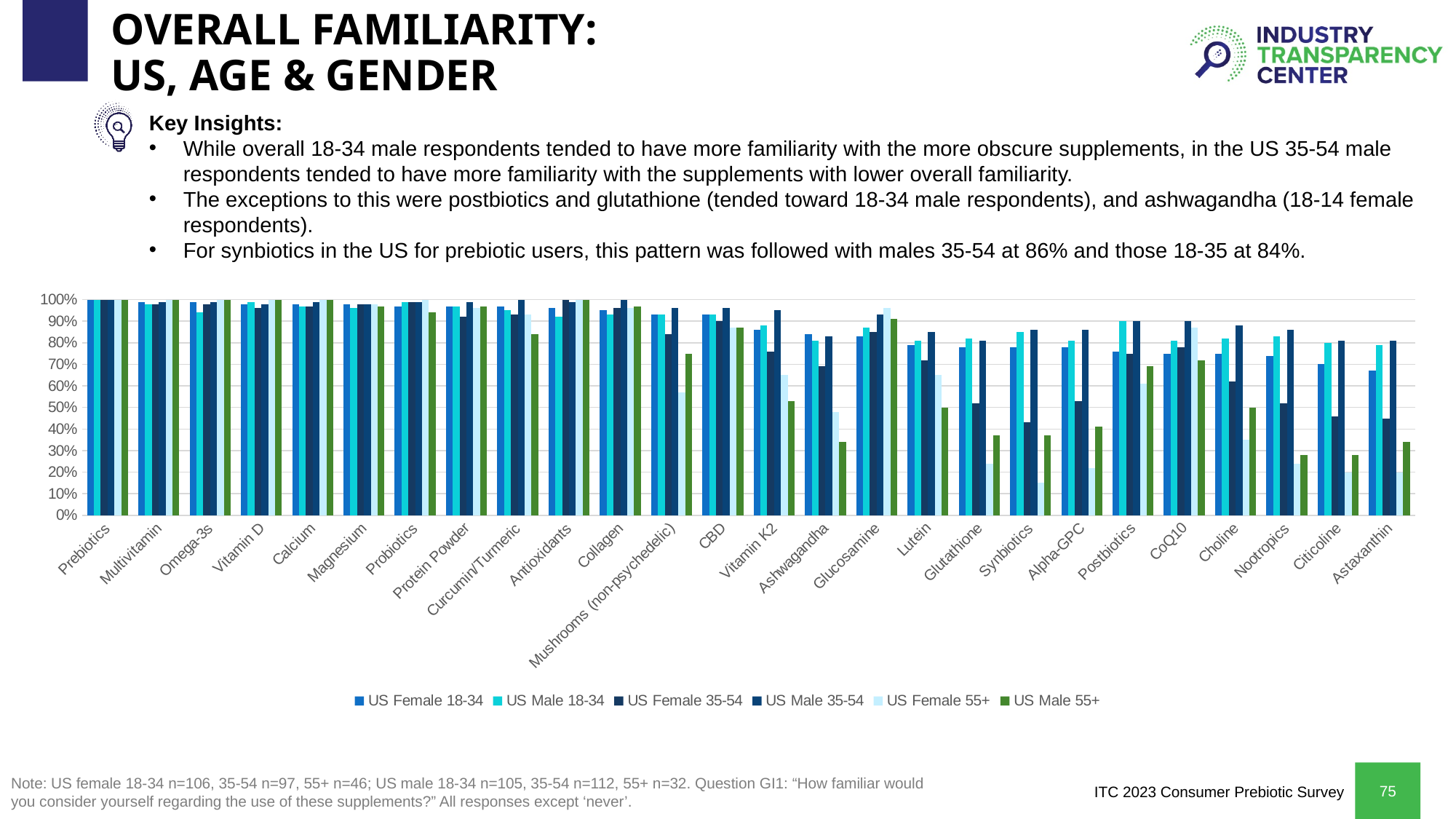
For Choline, which is larger: the value for US Male 35-54 or the value for US Female 55+? US Male 35-54 Is the value for US Female 55+ for Citicoline greater or less than 50%? less For Astaxanthin, which is larger: the value for US Male 35-54 or the value for US Female 55+? US Male 35-54 Is the value for US Male 55+ for Astaxanthin greater or less than 50%? less Which series is shown in green in the chart legend? US Male 55+ How many series does the chart legend list? 6 Is the value for US Male 55+ for Prebiotics greater or less than 90%? greater How many supplement categories are shown on the x axis of the chart? 26 What kind of chart is shown on the slide? bar chart Do the familiarity values generally rise or fall moving from left to right along the x axis? fall